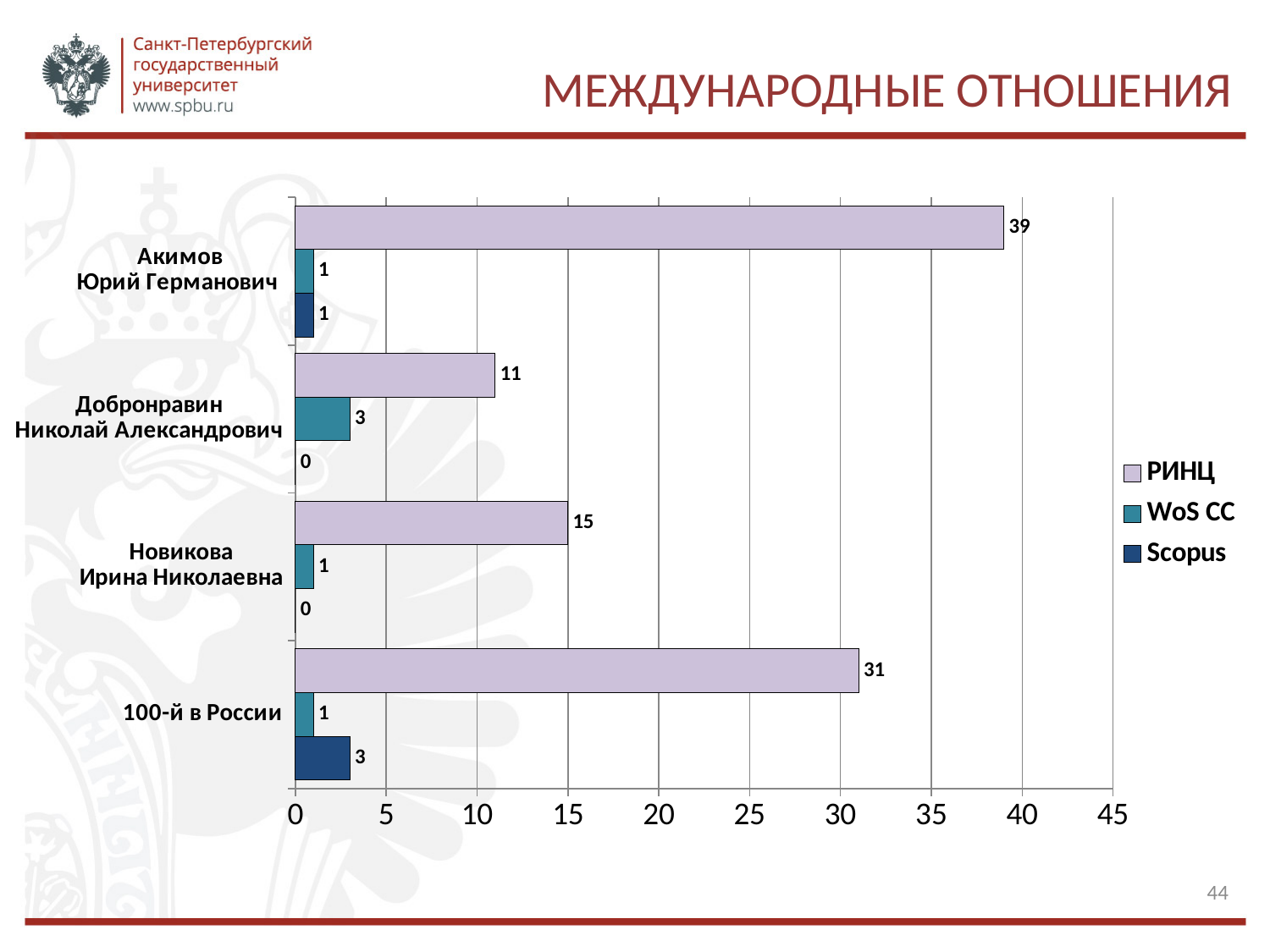
What is the Scopus value for 100-й в России? 3 How many series does the legend list? 3 Which category has the highest РИНЦ value? Акимов Юрий Германович What is the difference between the РИНЦ values for Акимов Юрий Германович and 100-й в России? 8 What is the Scopus value for Новикова Ирина Николаевна? 0 Which category has the lowest РИНЦ value? Добронравин Николай Александрович What are the series names listed in the legend? РИНЦ, WoS CC, Scopus Which is larger: the РИНЦ value for Новикова Ирина Николаевна or for Добронравин Николай Александрович? Новикова Ирина Николаевна How many categories are shown on the chart? 4 What is the РИНЦ value for Акимов Юрий Германович? 39 What kind of chart is shown on the slide? bar chart What is the WoS CC value for Добронравин Николай Александрович? 3